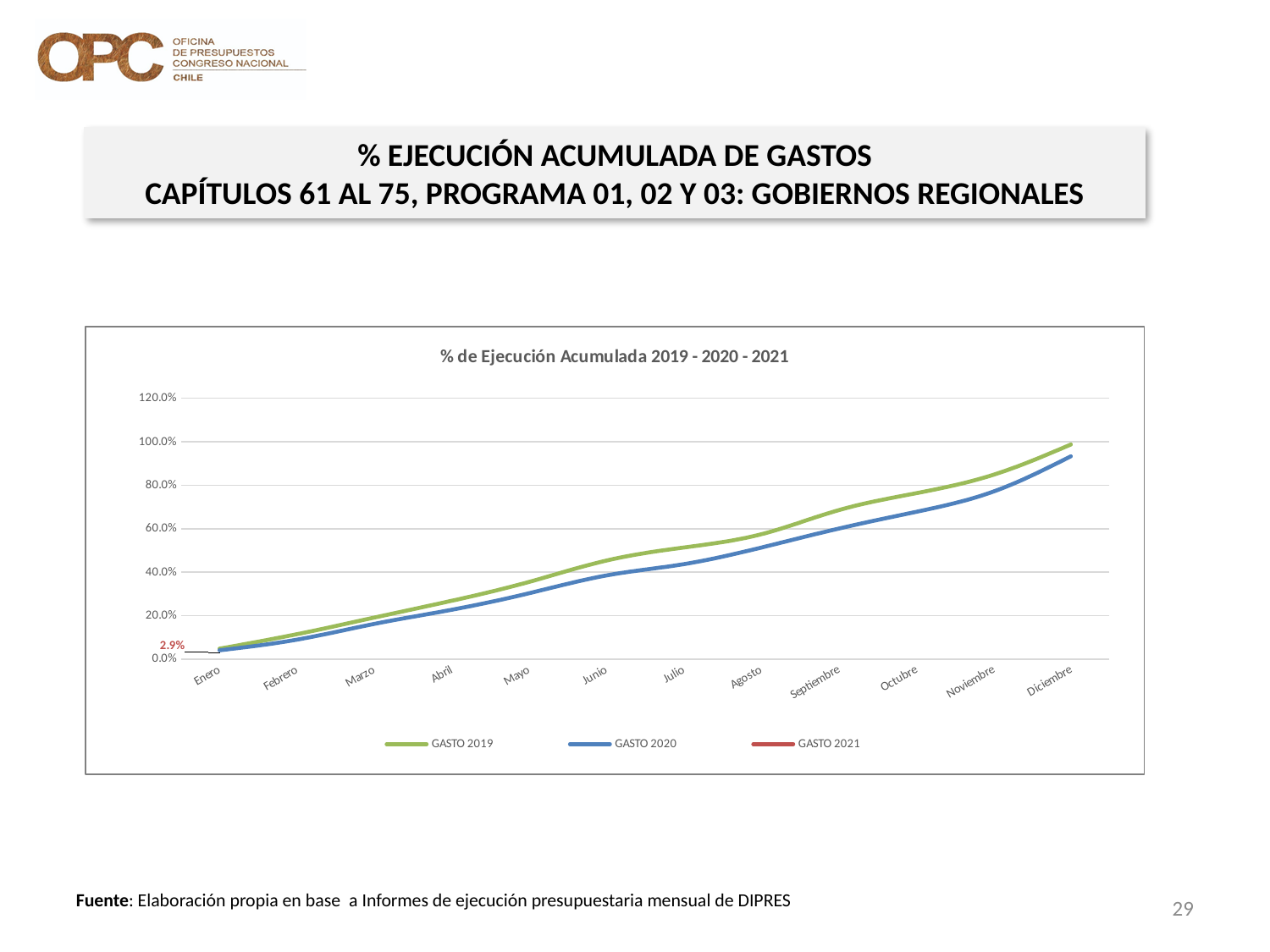
Do the GASTO 2019 values rise or fall from Enero to Diciembre? rise How many series does the legend list? 3 How many months are shown along the x axis? 12 Is the value for GASTO 2020 in Diciembre greater or less than 80%? greater What type of chart is shown on the slide? line chart Which legend entry is drawn in green? GASTO 2019 What is the value labelled for GASTO 2021 in Enero? 2.9% In Diciembre, which series is higher, GASTO 2019 or GASTO 2020? GASTO 2019 Is the value for GASTO 2019 in Septiembre greater or less than 60%? greater What is the title of the chart? % de Ejecución Acumulada 2019 - 2020 - 2021